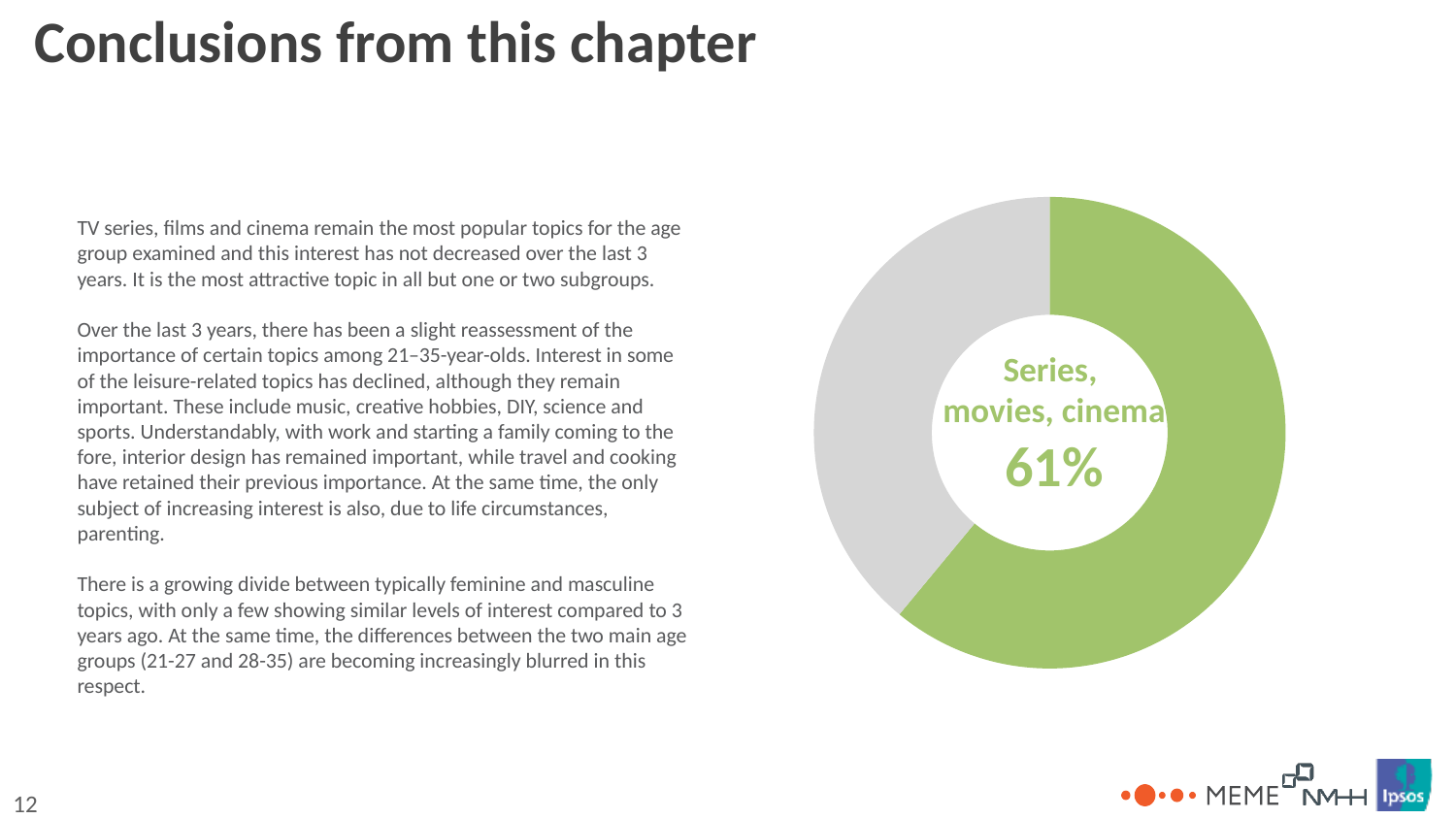
Which slice of the donut chart is larger, the green one or the grey one? The green one (Series, movies, cinema) Is the value for Series, movies, cinema greater or less than 50%? greater How many slices does the donut chart have? 2 What percentage is shown for Series, movies, cinema in the donut chart? 61% What label is printed in the centre of the donut chart? Series, movies, cinema 61% What share of the donut chart does the Series, movies, cinema slice represent? 61% What kind of chart is shown on the slide? Donut (pie) chart What colour is the slice representing Series, movies, cinema? Green